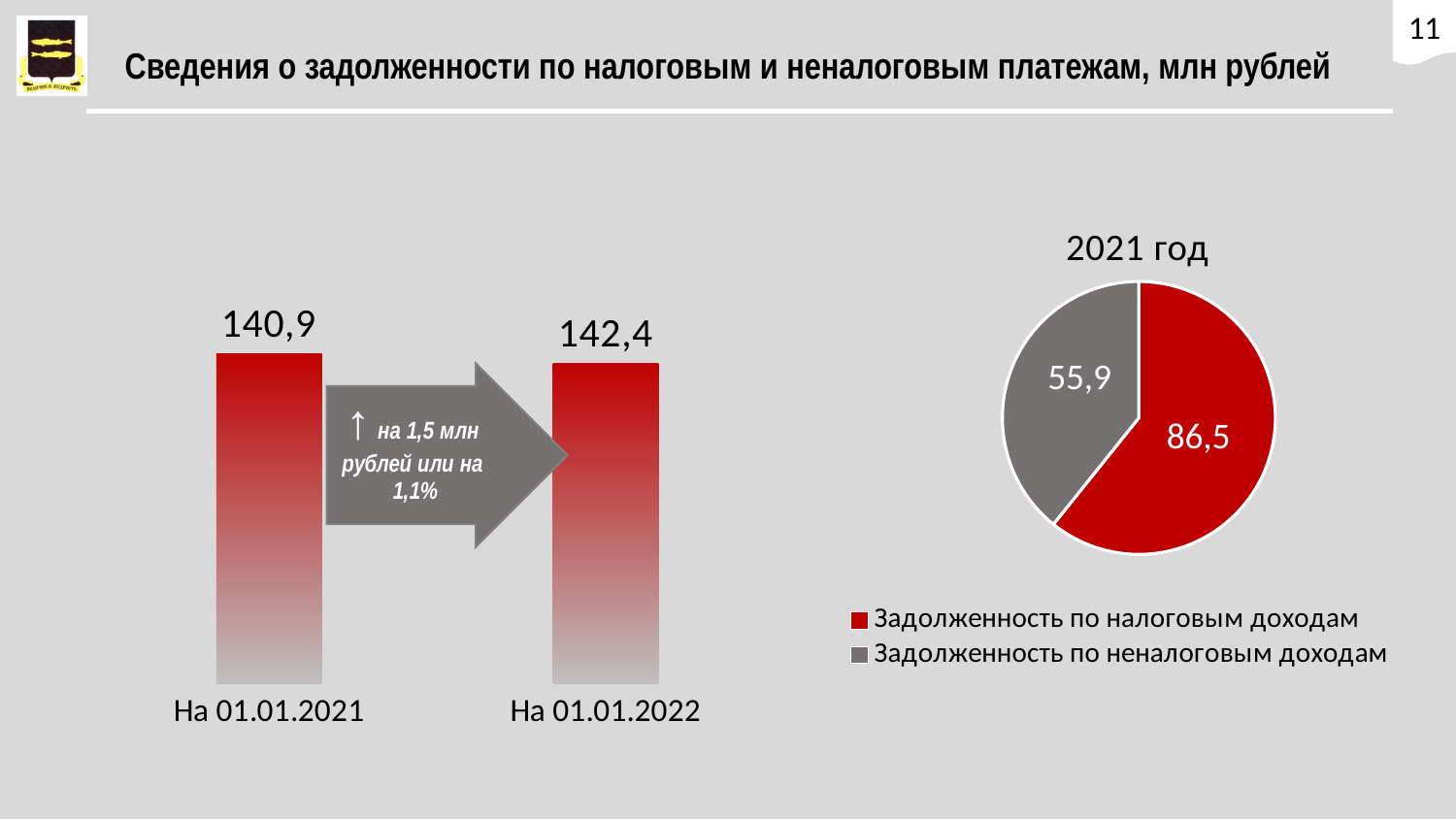
In the bar chart on the left, which date has the higher value? На 01.01.2022 How many entries does the legend of the pie chart titled 2021 год list? 2 In the bar chart on the left, what is the difference between the values for На 01.01.2022 and На 01.01.2021? 1,5 In the pie chart titled 2021 год, what is the value for Задолженность по неналоговым доходам? 55,9 In the bar chart on the left, how many bars are shown? 2 In the bar chart on the left, do the values rise or fall from На 01.01.2021 to На 01.01.2022? rise What kind of chart is shown on the left of the slide? bar chart In the bar chart on the left, what is the value for На 01.01.2022? 142,4 In the pie chart titled 2021 год, what is the difference between the two slices? 30,6 In the bar chart on the left, what is the value for На 01.01.2021? 140,9 In the pie chart titled 2021 год, what is the value for Задолженность по налоговым доходам? 86,5 In the pie chart titled 2021 год, which slice is larger: Задолженность по налоговым доходам or Задолженность по неналоговым доходам? Задолженность по налоговым доходам